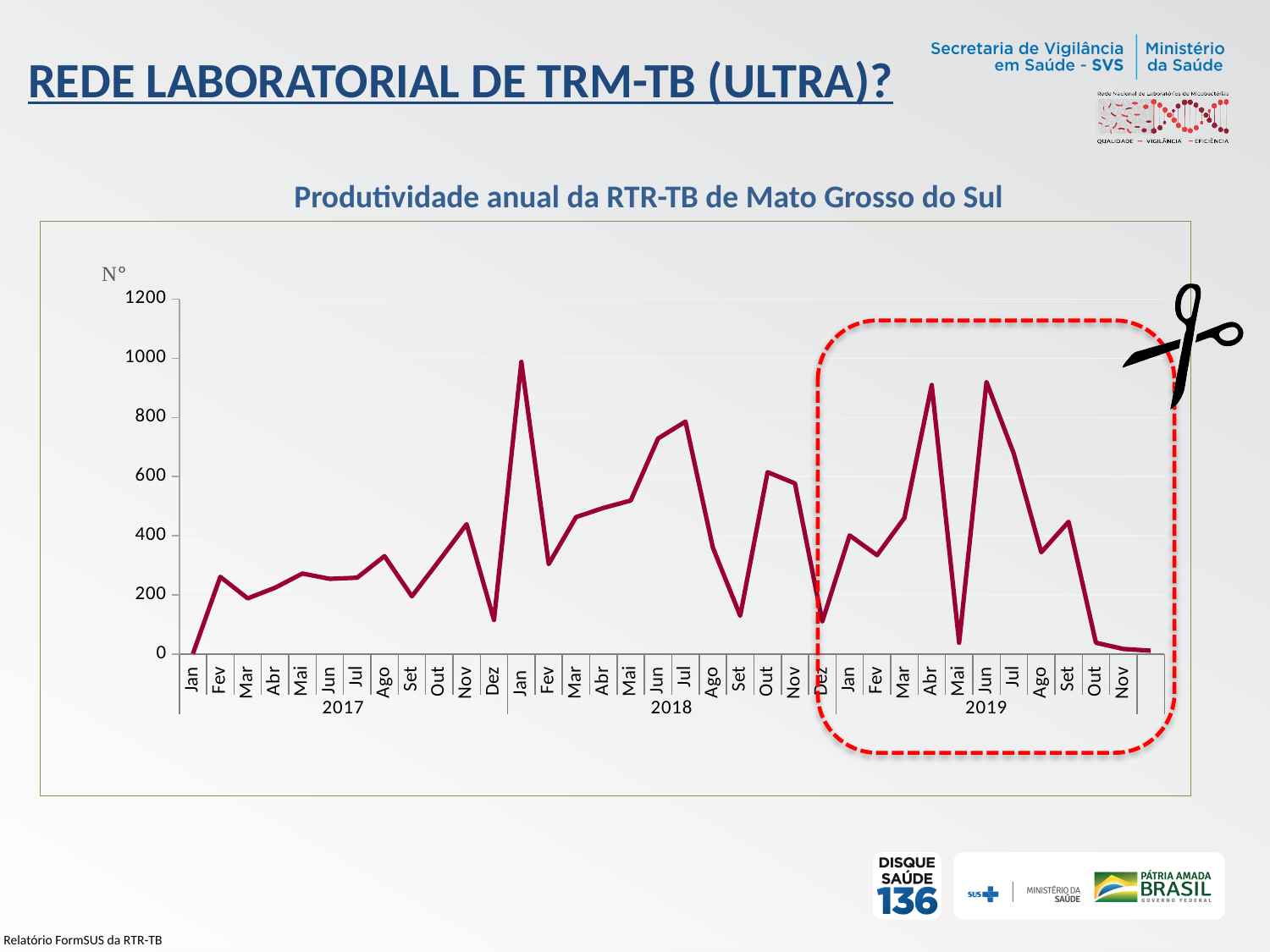
Which month has the lowest value on the chart? Jan 2017 Which month has the highest value on the chart? Jan 2018 Is the value for Mai 2019 greater or less than 200? less What label is shown on the vertical axis of the chart? N° Is the value for Jul 2018 greater or less than 600? greater Is the value for Jan 2018 greater or less than 800? greater What kind of chart is shown on the slide? line chart What is the title of the chart? Produtividade anual da RTR-TB de Mato Grosso do Sul Which is larger, the value for Jan 2018 or the value for Fev 2018? Jan 2018 Do the values rise or fall from Jan 2017 to Mai 2017? rise How many years are shown along the x axis of the chart? 3